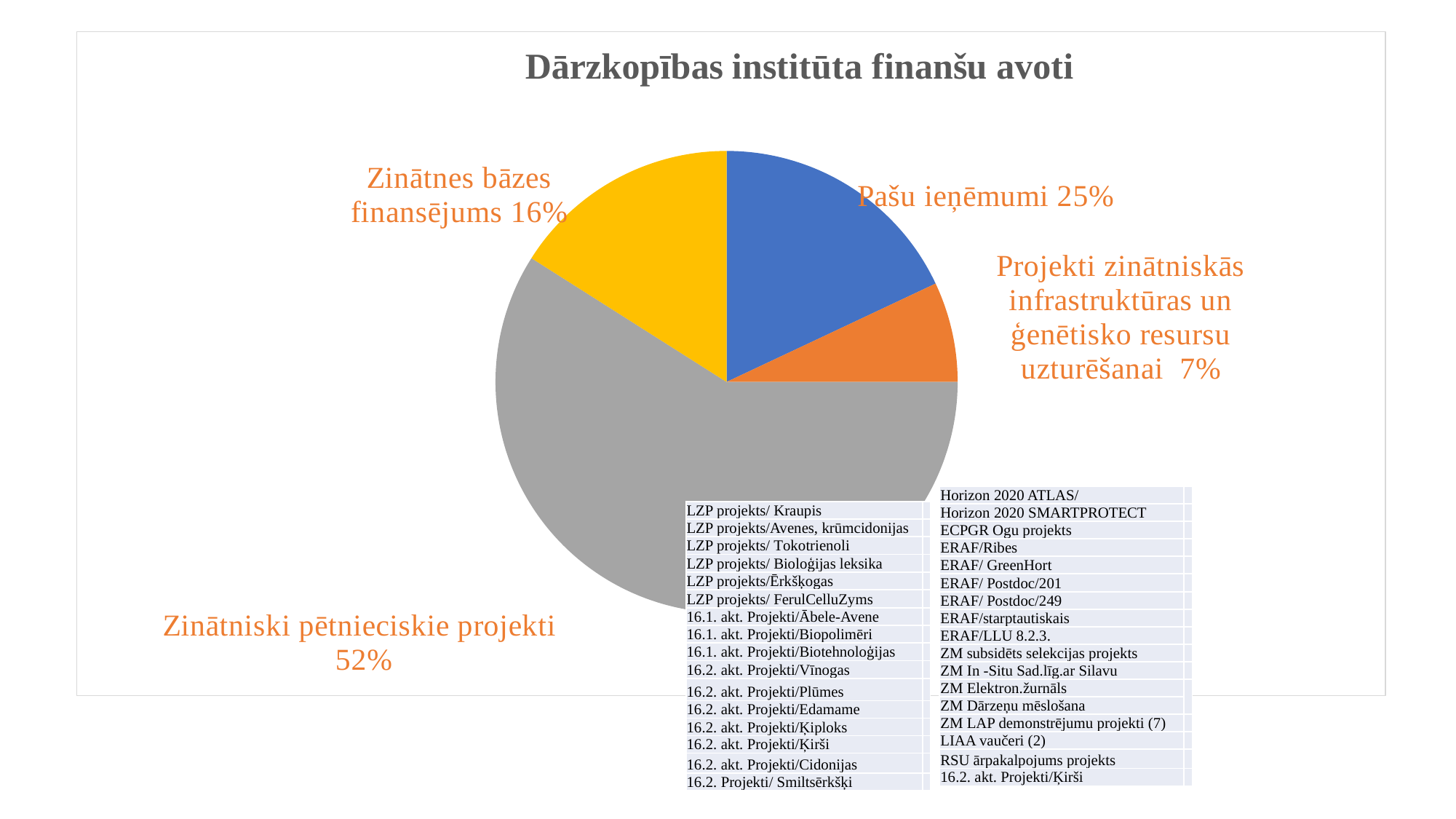
Which is larger, the share for Pašu ieņēmumi or the share for Zinātnes bāzes finansējums? Pašu ieņēmumi What share of the pie is Projekti zinātniskās infrastruktūras un ģenētisko resursu uzturēšanai? 7% Which category has the largest share of the pie? Zinātniski pētnieciskie projekti Which category has the smallest share of the pie? Projekti zinātniskās infrastruktūras un ģenētisko resursu uzturēšanai What share of the pie is Pašu ieņēmumi? 25% What kind of chart is shown on the slide? pie chart What share of the pie is Zinātnes bāzes finansējums? 16% What is the title of the chart? Dārzkopības institūta finanšu avoti How many slices does the pie chart have? 4 What is the difference in percentage points between Zinātniski pētnieciskie projekti and Pašu ieņēmumi? 27% What colour is the slice for Zinātniski pētnieciskie projekti? grey